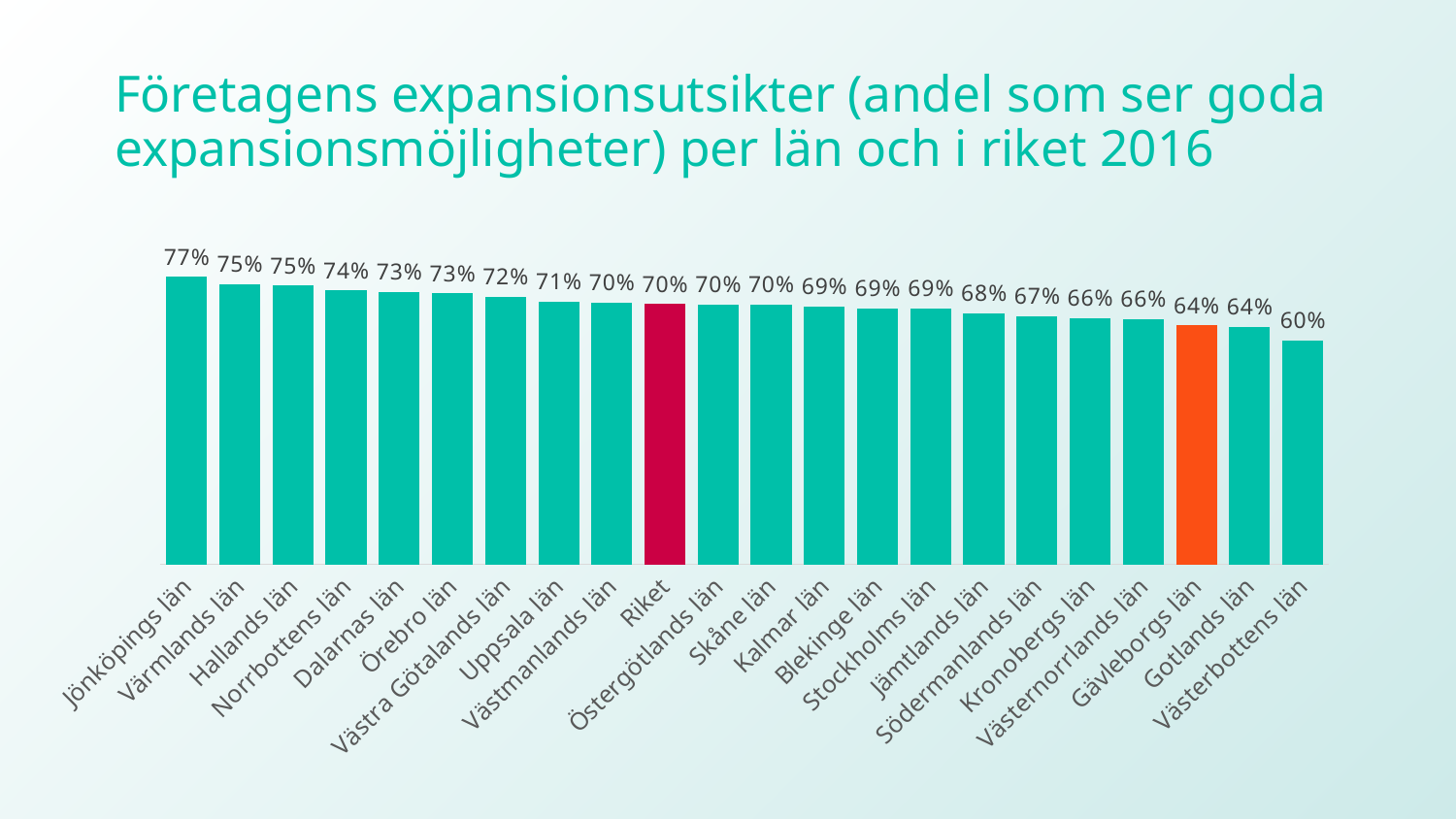
What is the value for Jönköpings län? 77% What is the difference between the values for Riket and Gävleborgs län? 6% What is the difference between the values for Jönköpings län and Västerbottens län? 17% Which category has the lowest value? Västerbottens län Which bar is coloured orange? Gävleborgs län What is the value for Stockholms län? 69% How many bars are shown in the chart? 22 What kind of chart is shown on the slide? Bar chart What is the value for Gävleborgs län? 64% Which category has the highest value? Jönköpings län What is the value for Riket? 70% Which is larger, the value for Norrbottens län or the value for Jämtlands län? Norrbottens län